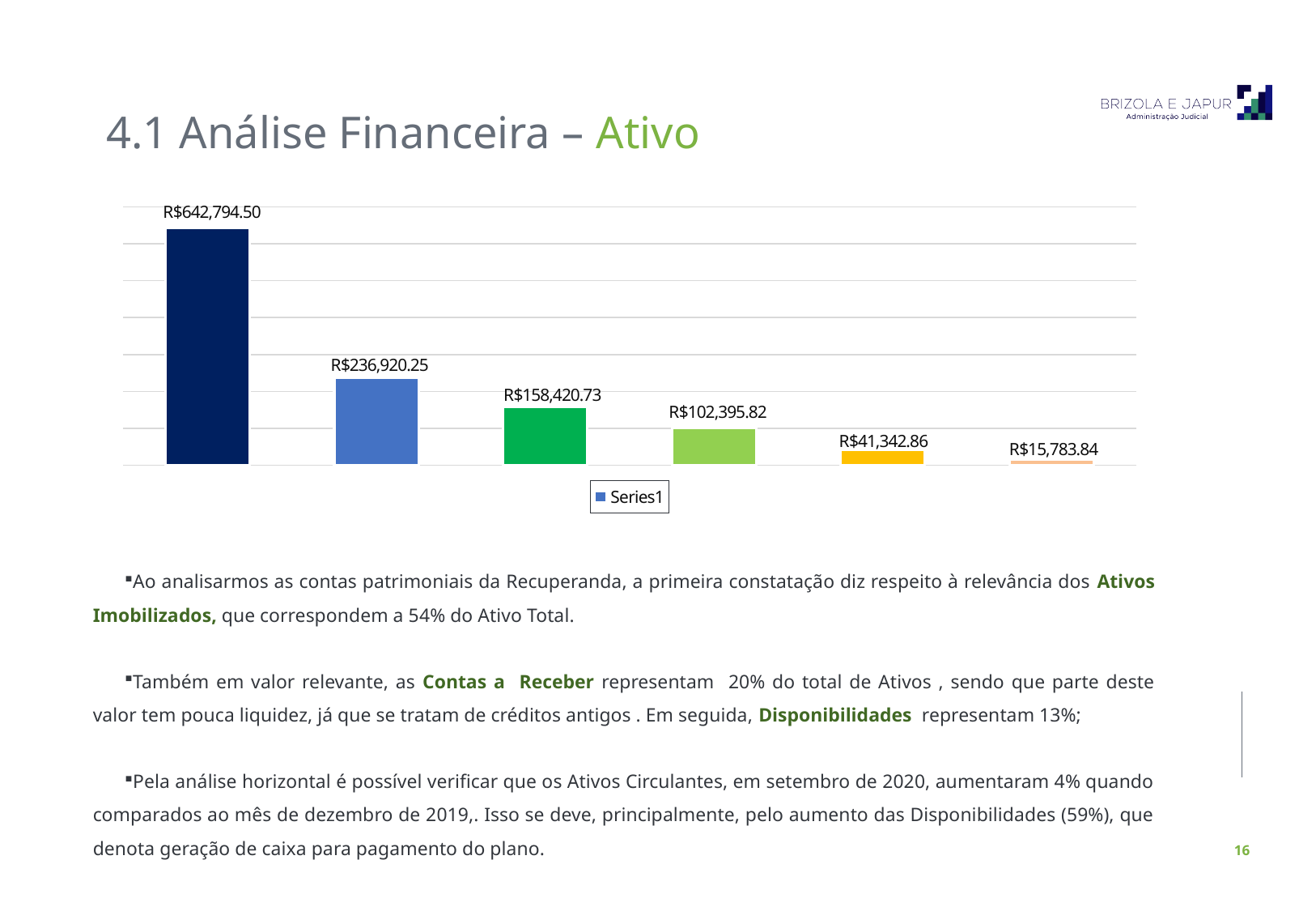
What value is labelled on the yellow bar, fifth from the left? R$41,342.86 What value is labelled on the green bar, third from the left? R$158,420.73 How many series does the chart legend list? 1 What kind of chart is shown on the slide? bar chart Which is larger: the light green bar (fourth from the left) or the yellow bar (fifth from the left)? the light green bar (R$102,395.82) What is the difference between the first bar (R$642,794.50) and the second bar (R$236,920.25)? R$405,874.25 What is the name of the series shown in the chart legend? Series1 What value is labelled on the second bar from the left (the medium blue bar)? R$236,920.25 What is the value shown on the tallest bar in the chart? R$642,794.50 What is the value shown on the shortest bar in the chart? R$15,783.84 How many bars does the chart contain? 6 Do the bar values rise or fall from left to right across the chart? fall